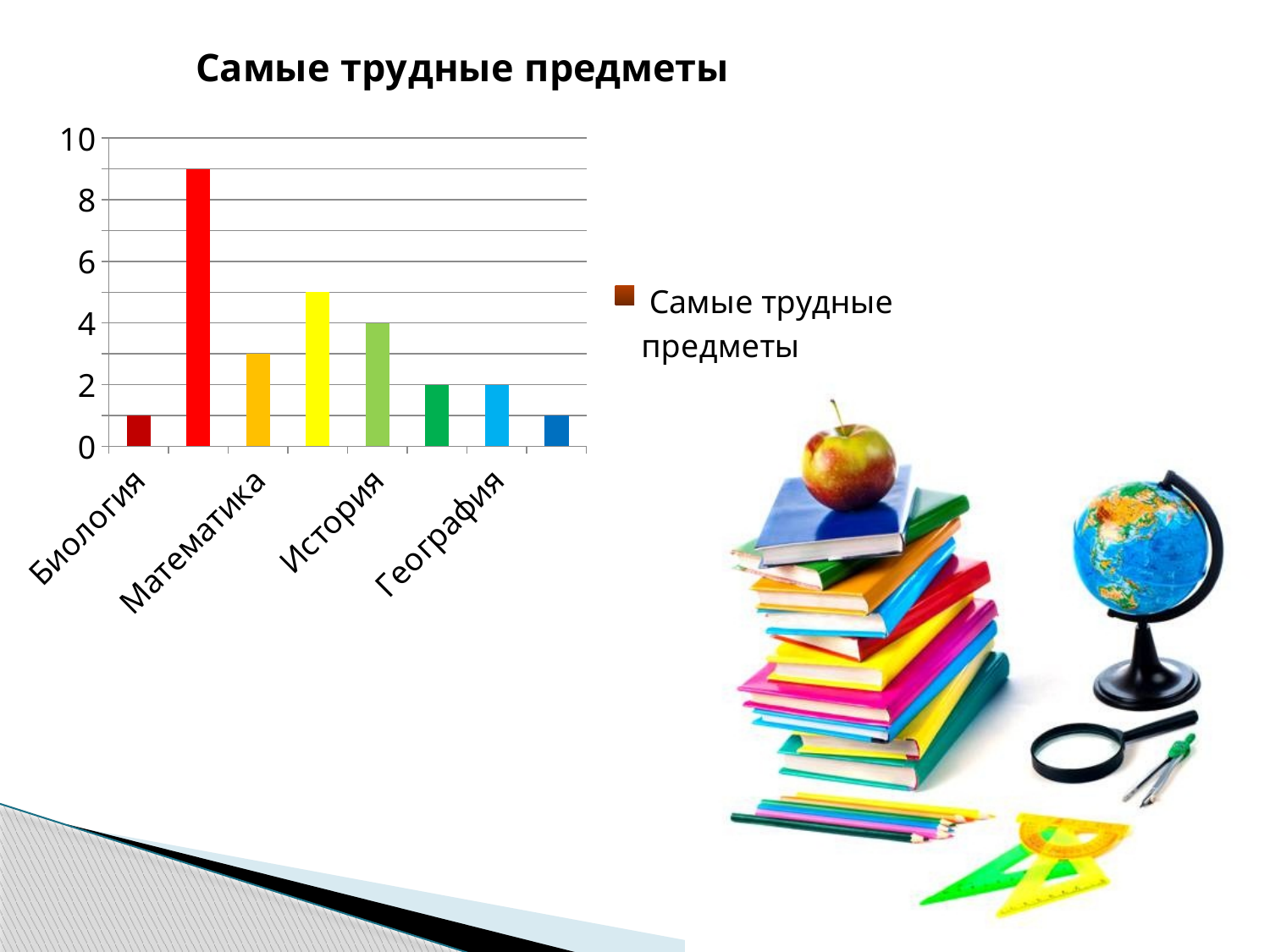
How many series does the legend list? 1 Is the value for Математика greater or less than 4? less What is the value for География? 2 Is the value for Биология greater or less than 2? less Which is larger, the value for История or the value for География? История What is the difference between the values for История and География? 2 Which is larger, the value for Биология or the value for География? География What is the value for История? 4 What kind of chart is shown on the slide? bar chart How many bars does the chart contain? 8 What is the title of the chart? Самые трудные предметы Is the value for Математика greater or less than 2? greater